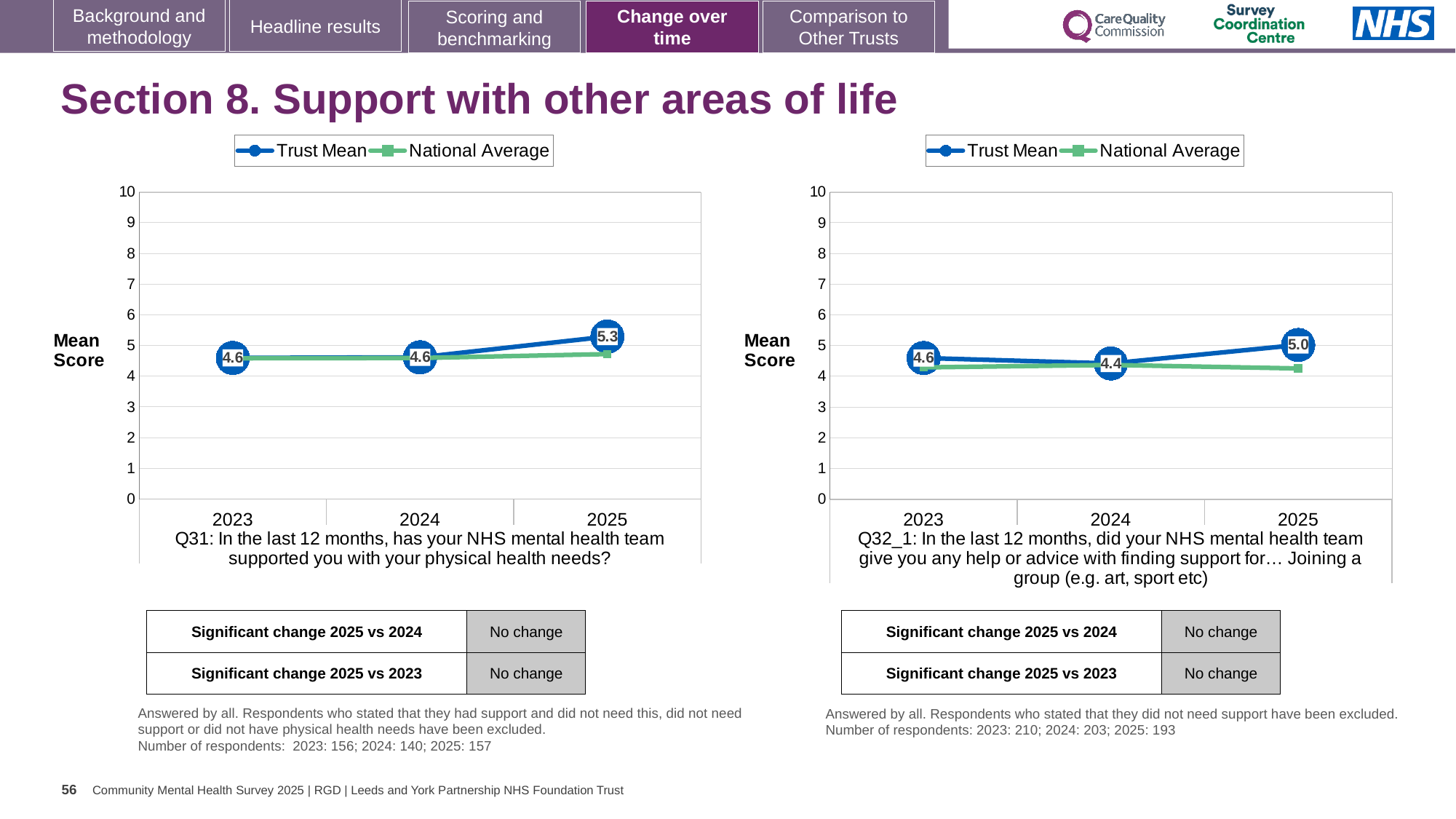
On the Q31 chart (left), which year has the highest Trust Mean? 2025 On the Q31 chart (left), what is the Trust Mean for 2023? 4.6 On the Q32_1 chart (right), which year has the lowest Trust Mean? 2024 On the Q32_1 chart (right), what is the difference between the Trust Mean in 2025 and in 2023? 0.4 On the Q32_1 chart (right), what is the Trust Mean for 2025? 5.0 On the Q31 chart (left), what is the difference between the Trust Mean in 2025 and in 2024? 0.7 On the Q32_1 chart (right), what is the Trust Mean for 2024? 4.4 Is the 2025 Trust Mean higher on the Q31 chart (left) or on the Q32_1 chart (right)? Q31 chart (left) On the Q31 chart (left), what is the Trust Mean for 2025? 5.3 How many series does the legend of the Q31 chart (left) list? 2 What type of chart is used for Q32_1 (right)? Line chart On the Q32_1 chart (right), is the National Average for 2025 greater or less than 5? less